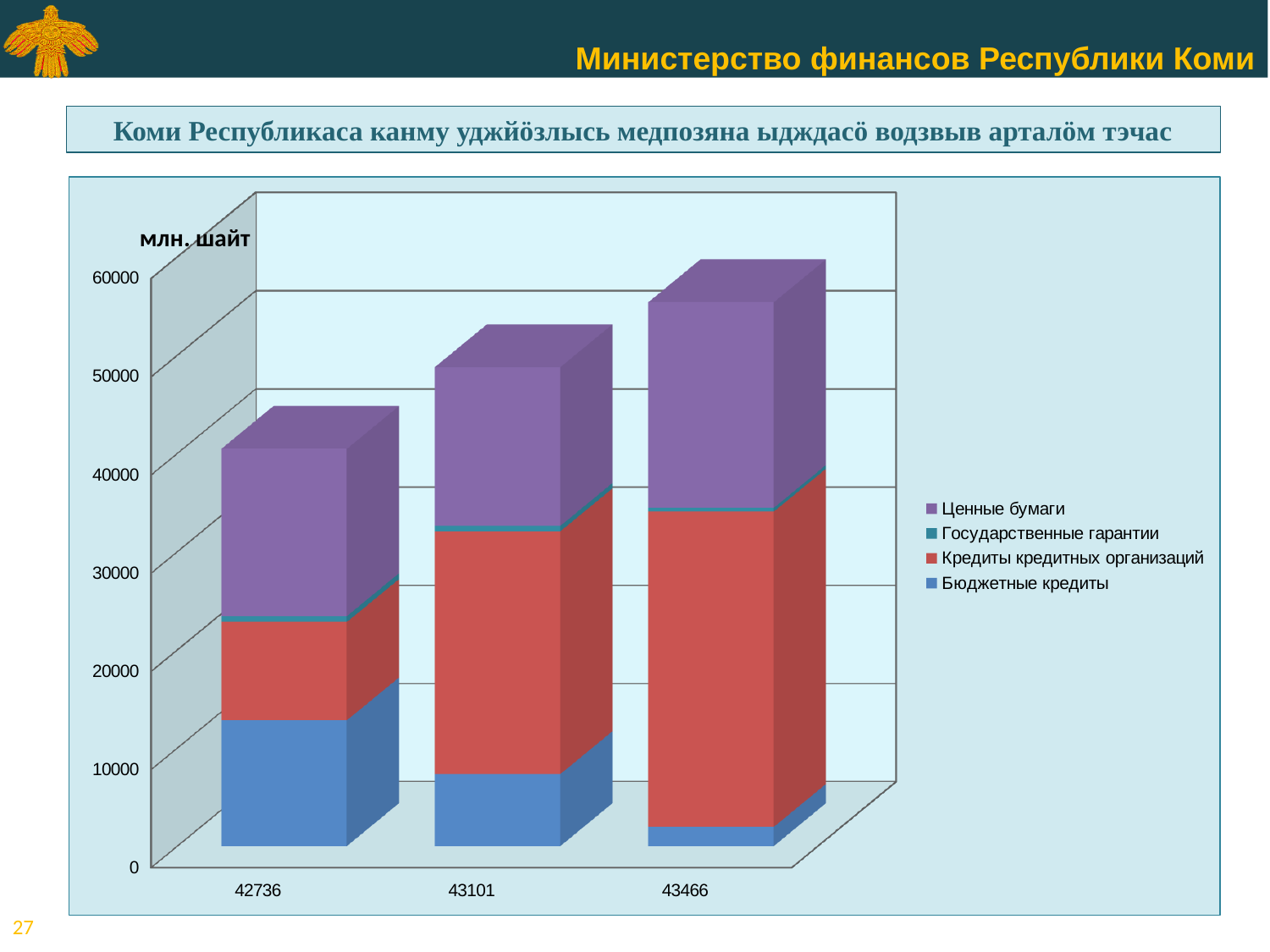
How many categories are shown along the x axis? 3 What unit label is shown at the top of the value axis? млн. шайт Does the Бюджетные кредиты segment rise or fall from 42736 to 43466? Fall Do the total stacked bar heights rise or fall from 42736 to 43466? Rise Which category has the larger Бюджетные кредиты segment, 42736 or 43466? 42736 Is the Бюджетные кредиты value for 42736 greater or less than 10000? greater What kind of chart is shown on the slide? Stacked bar chart Which category has the highest total stacked bar? 43466 How many series does the legend list? 4 Which category has the lowest total stacked bar? 42736 Is the Бюджетные кредиты value for 43466 greater or less than 10000? less Is the total stacked bar for 43466 greater or less than 50000? greater